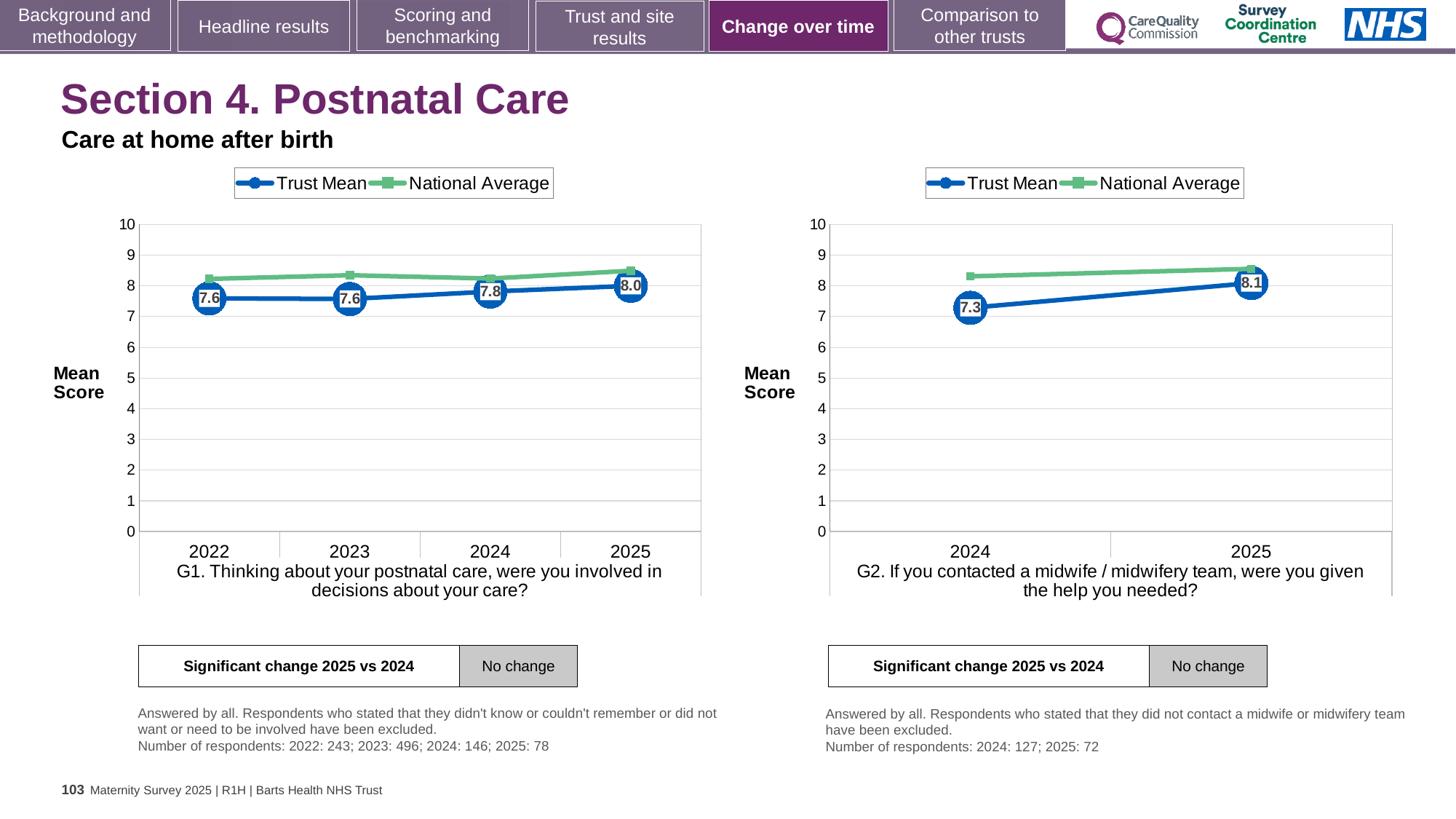
What kind of chart is the G1 chart on the left? Line chart How many years are plotted in the G1 chart on the left? 4 In the G1 chart on the left, what is the difference between the Trust Mean for 2025 and the Trust Mean for 2022? 0.4 In the G1 chart on the left, what is the Trust Mean for 2025? 8.0 In the G2 chart on the right, which year has the lowest Trust Mean? 2024 In the G1 chart on the left, is the National Average for 2022 greater or less than 8? greater In the G2 chart on the right, what is the Trust Mean for 2025? 8.1 In the G2 chart on the right, what is the difference between the Trust Mean for 2025 and the Trust Mean for 2024? 0.8 How many series does the legend of the G2 chart on the right list? 2 In the G2 chart on the right, what is the Trust Mean for 2024? 7.3 In the G1 chart on the left, what is the Trust Mean for 2024? 7.8 In the G1 chart on the left, which year has the highest Trust Mean? 2025